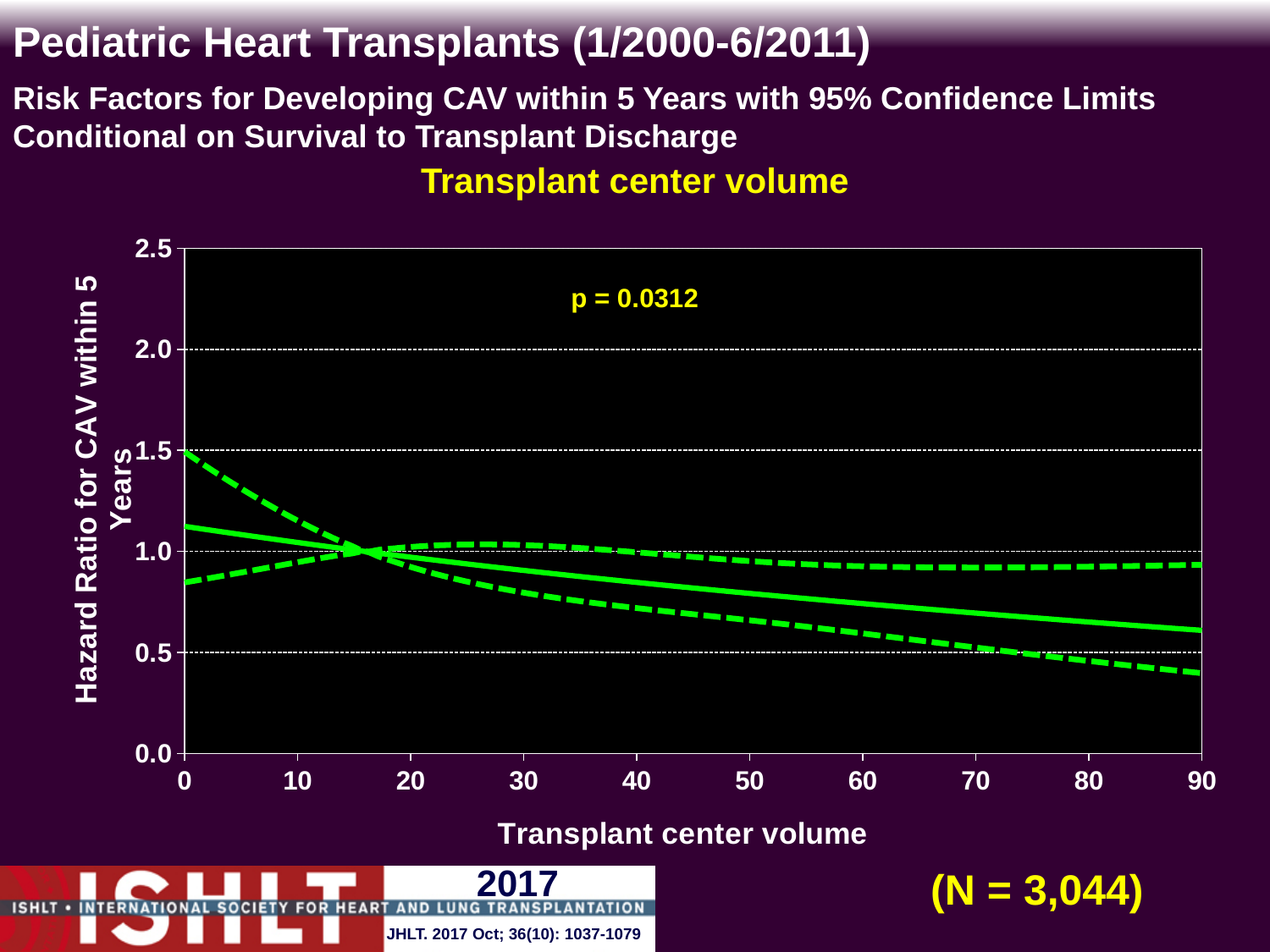
Is the solid hazard ratio line at a transplant center volume of 90 greater or less than 1.0? less What is the sample size (N) shown on the slide? N = 3,044 What is the p-value printed on the chart? p = 0.0312 What is the label of the x axis? Transplant center volume Does the solid hazard ratio line rise or fall as transplant center volume increases along the x axis? Fall What is the label of the y axis? Hazard Ratio for CAV within 5 Years Is the lower dashed confidence limit at a transplant center volume of 90 greater or less than 0.5? less Is the solid hazard ratio line at a transplant center volume of 90 greater or less than 0.5? greater What kind of chart is shown on the slide? Line chart How many lines are plotted on the chart? 3